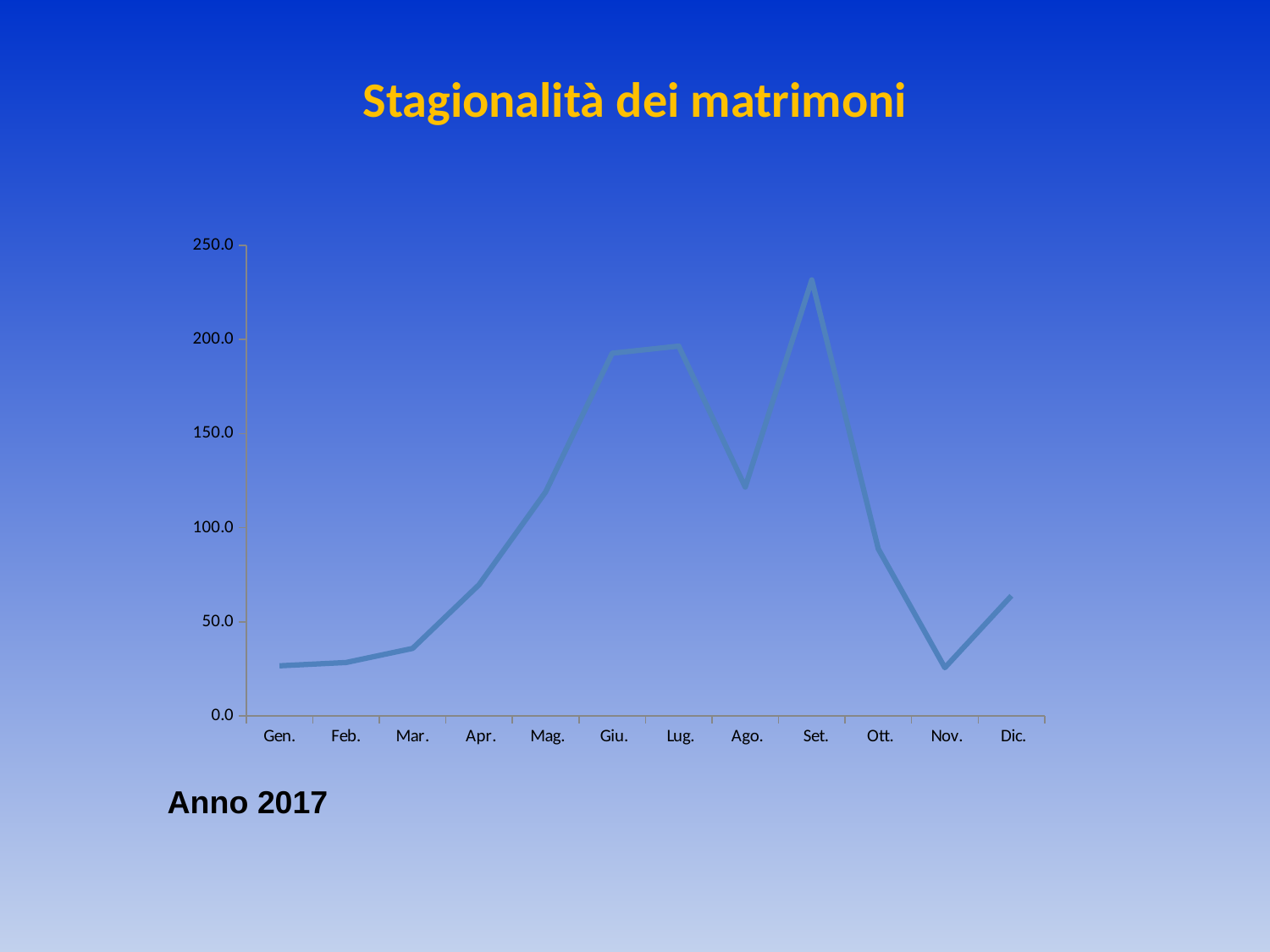
Is the value for Giu. greater or less than 150? greater Is the value for Ott. greater or less than 100? less Is the value for Set. greater or less than 200? greater How many months are plotted along the x axis? 12 What kind of chart is shown on the slide? line chart Do the values rise or fall from Gen. to Giu.? rise Which month has the highest value on the chart? Set. Do the values rise or fall from Set. to Nov.? fall Which is larger, the value for Set. or the value for Lug.? Set. What is the title of the chart on the slide? Stagionalità dei matrimoni